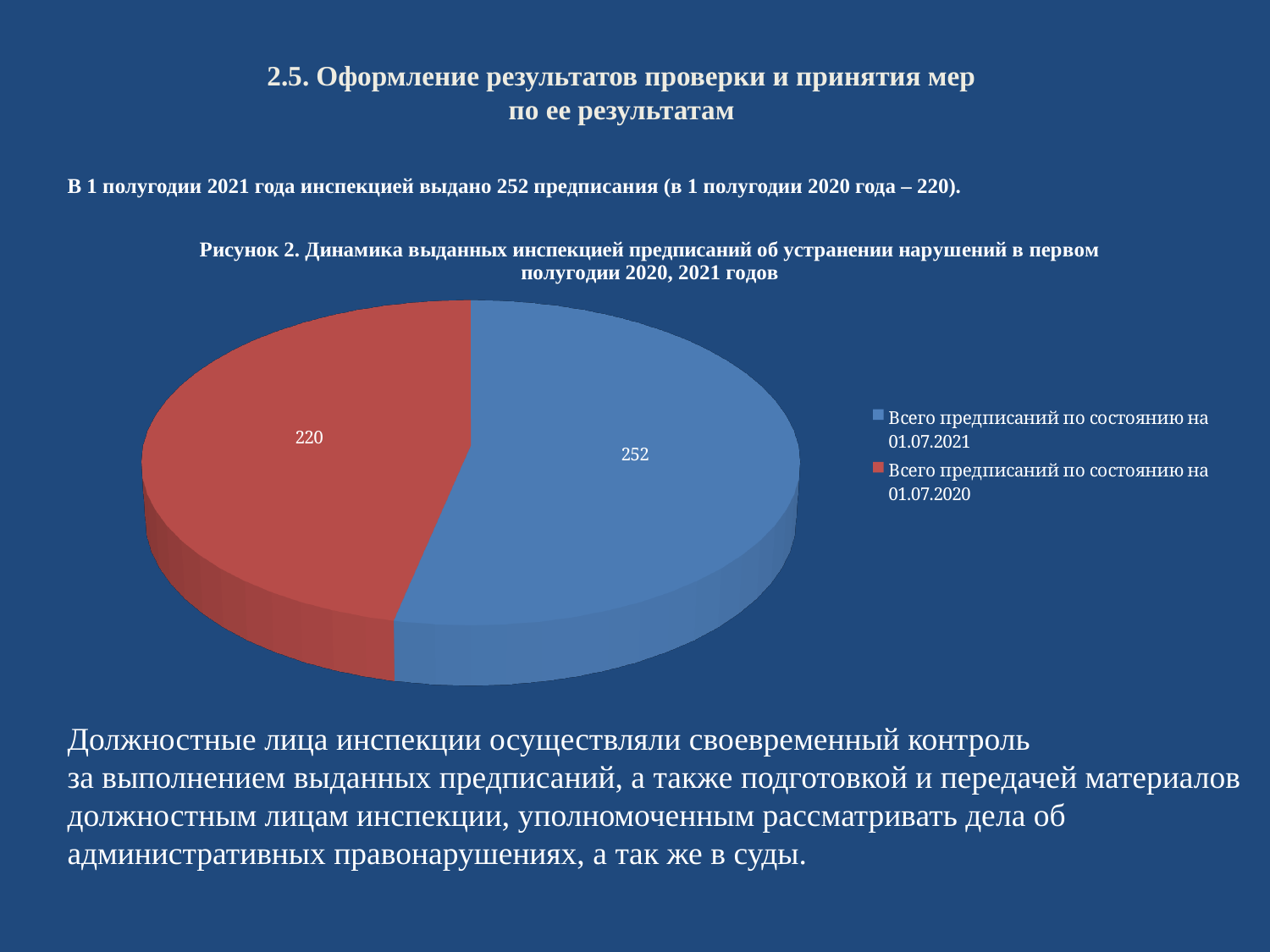
How many entries does the legend list? 2 What is the value for "Всего предписаний по состоянию на 01.07.2021"? 252 What colour is the slice for "Всего предписаний по состоянию на 01.07.2020"? red What type of chart is shown on the slide? pie chart Which category has the largest slice of the pie? Всего предписаний по состоянию на 01.07.2021 What is the title of the chart? Рисунок 2. Динамика выданных инспекцией предписаний об устранении нарушений в первом полугодии 2020, 2021 годов What is the difference between the value for 01.07.2021 and the value for 01.07.2020? 32 What is the total of the two values shown in the pie chart? 472 How many slices does the pie chart have? 2 Which category has the smallest slice of the pie? Всего предписаний по состоянию на 01.07.2020 What is the value for "Всего предписаний по состоянию на 01.07.2020"? 220 Which is larger: the value for 01.07.2021 or the value for 01.07.2020? 01.07.2021